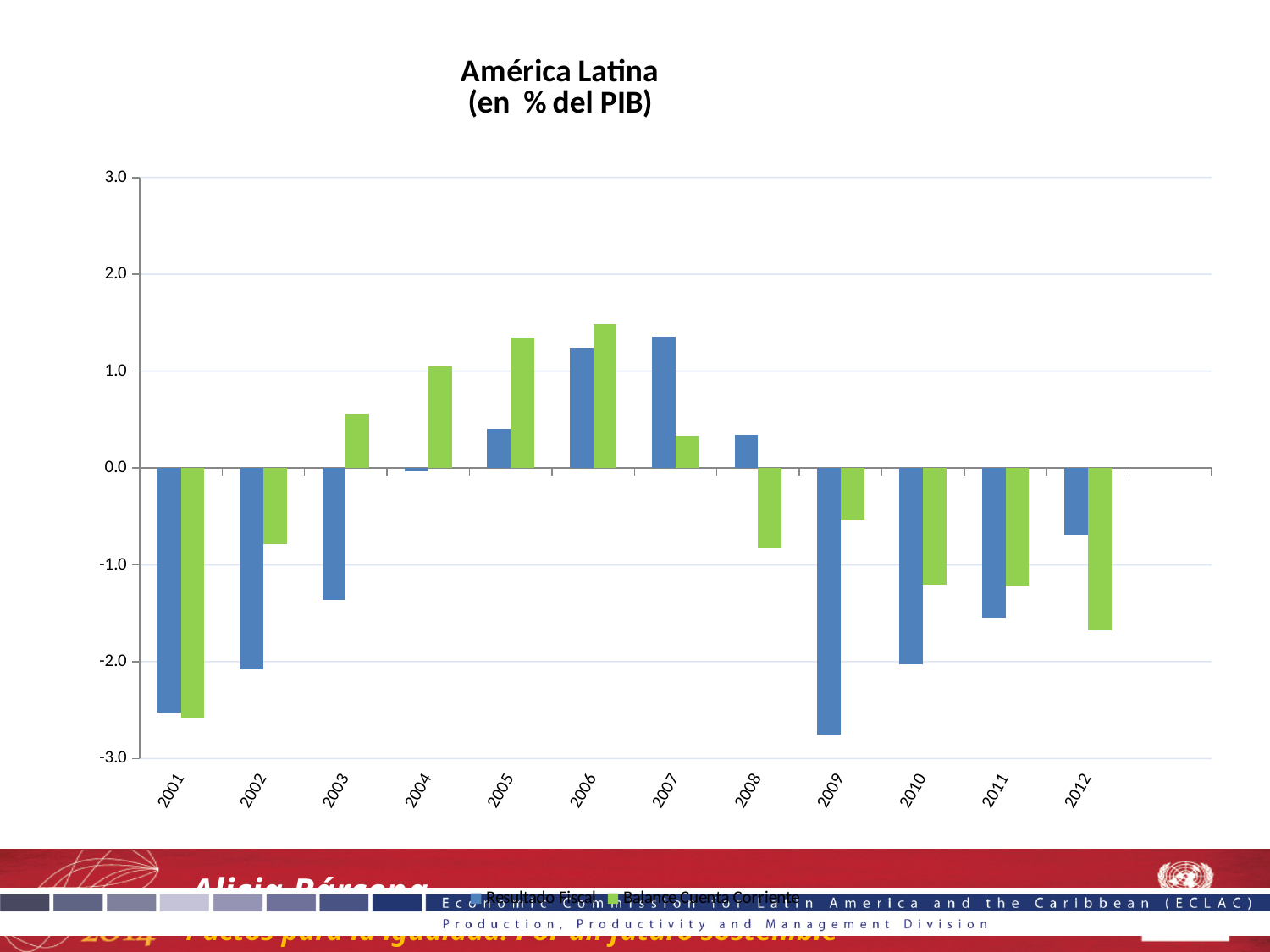
In which year is the Resultado Fiscal bar lowest? 2009 In which year is the Balance Cuenta Corriente bar lowest? 2001 Is the Resultado Fiscal value for 2003 greater or less than -1.0? less What are the two series named in the legend? Resultado Fiscal and Balance Cuenta Corriente Is the Balance Cuenta Corriente value for 2006 greater or less than 1.0? greater In 2007, which is larger: Resultado Fiscal or Balance Cuenta Corriente? Resultado Fiscal How many series does the legend list? 2 Is the Resultado Fiscal value for 2009 greater or less than -2.0? less What kind of chart is shown on the slide? bar chart In which year is the Balance Cuenta Corriente bar highest? 2006 In 2002, which is larger: Resultado Fiscal or Balance Cuenta Corriente? Balance Cuenta Corriente How many years are shown on the x axis of the chart? 12